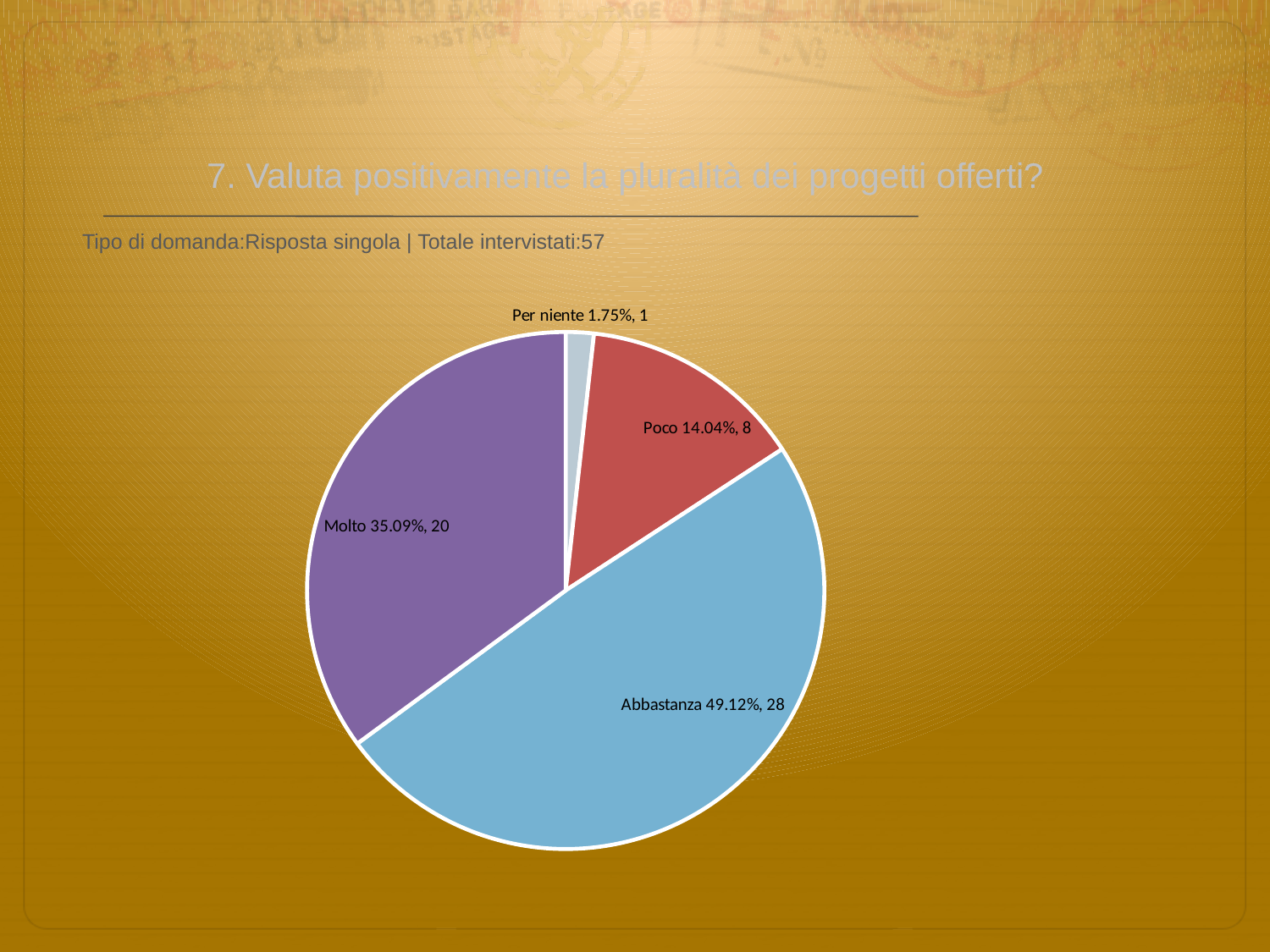
Which category has the smallest slice? Per niente What kind of chart is shown on the slide? pie chart How many respondents answered 'Poco'? 8 How many respondents answered 'Molto'? 20 What colour is the 'Molto' slice? purple Which has more respondents, 'Poco' or 'Molto'? Molto What percentage share does the 'Abbastanza' slice have? 49.12% How many slices does the pie chart have? 4 Which category has the largest slice? Abbastanza What is the total number of respondents shown on the slide? 57 What percentage share does the 'Per niente' slice have? 1.75% What is the difference in respondent count between 'Abbastanza' and 'Molto'? 8